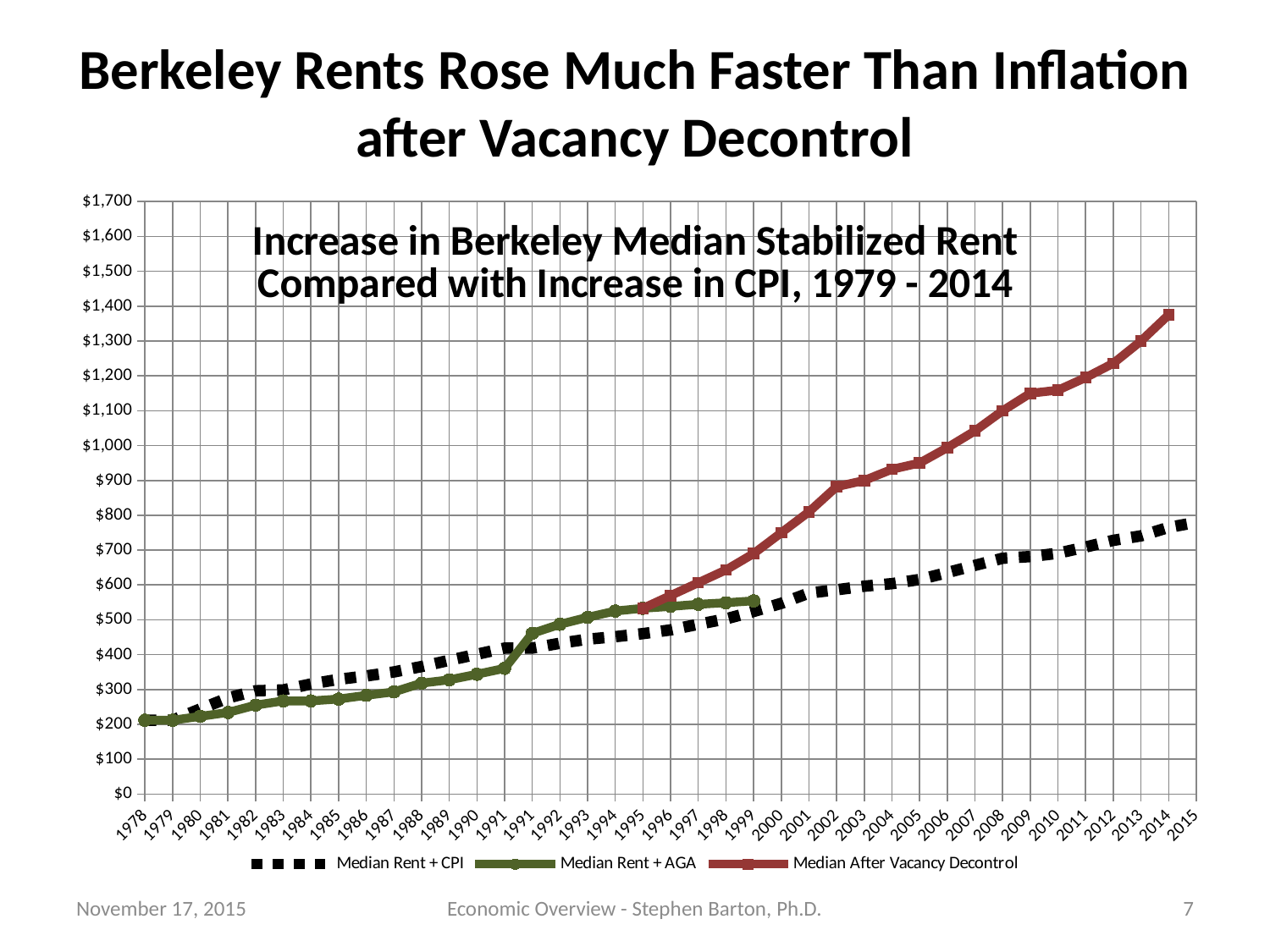
How many series does the chart's legend list? 3 Is the value for Median Rent + AGA in 1978 greater or less than $300? less Is the value for Median After Vacancy Decontrol in 2009 greater or less than $1,100? greater Does the Median After Vacancy Decontrol series rise or fall from 1995 to 2014? Rise What is the title printed inside the chart area? Increase in Berkeley Median Stabilized Rent Compared with Increase in CPI, 1979 - 2014 What kind of chart is shown on the slide? Line chart Is the value for Median Rent + CPI in 2014 greater or less than $800? less Which series in the legend is drawn as a black dashed line? Median Rent + CPI In 2014, which series has the larger value: Median After Vacancy Decontrol or Median Rent + CPI? Median After Vacancy Decontrol In 1985, which series has the larger value: Median Rent + CPI or Median Rent + AGA? Median Rent + CPI